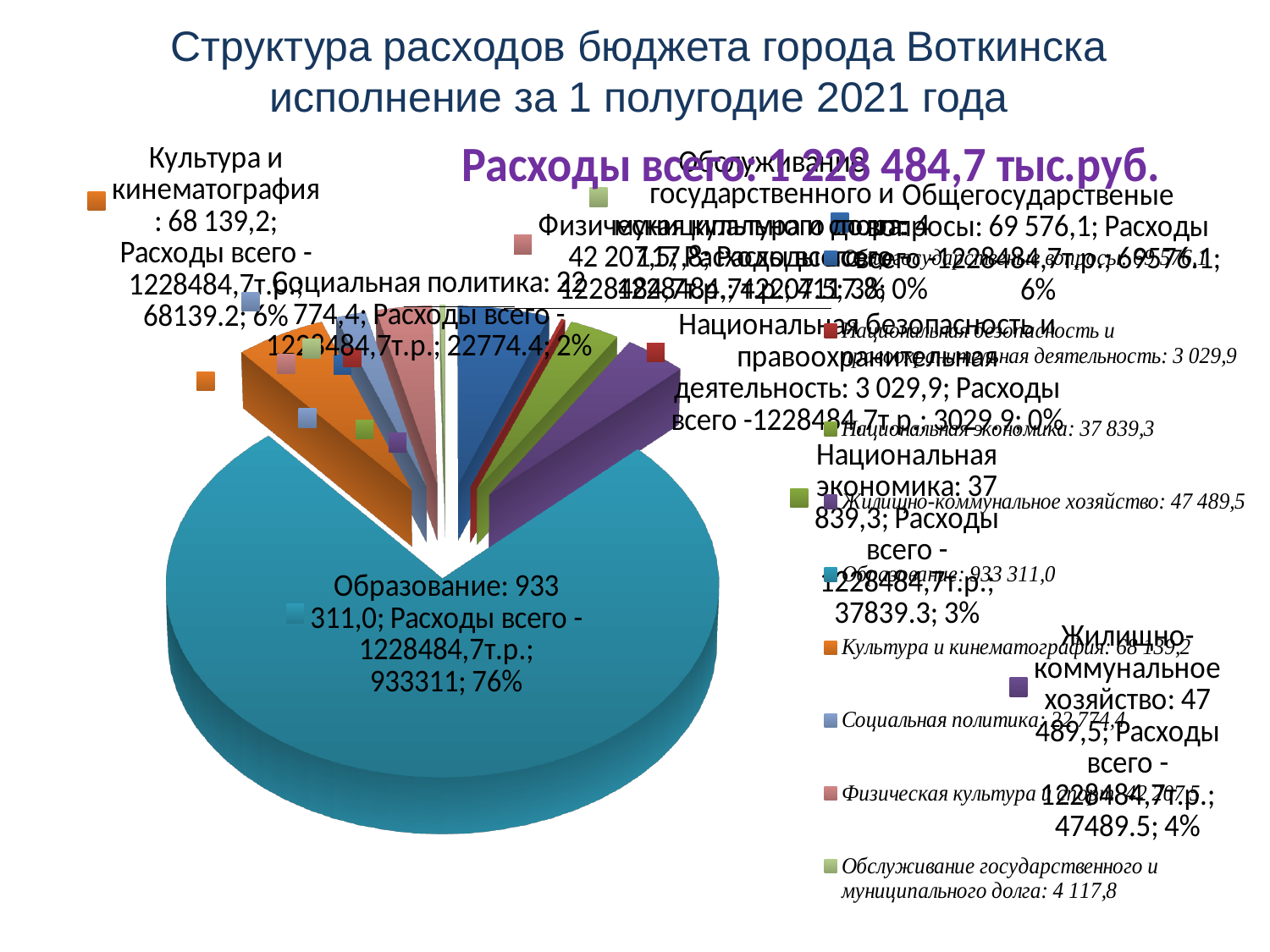
How many expenditure categories does the legend list? 9 What share of total expenditure does Образование account for? 76% What is the total expenditure shown on the slide (Расходы всего)? 1 228 484,7 тыс.руб. What is the value for Образование? 933 311,0 Which category has the largest share of expenditure? Образование Which category has the smallest value? Национальная безопасность и правоохранительная деятельность Which is larger: Общегосударственные вопросы or Культура и кинематография? Общегосударственные вопросы What is the difference between Общегосударственные вопросы (69 576,1) and Культура и кинематография (68 139,2)? 1 436,9 What kind of chart is shown on the slide? pie chart What share of total expenditure does Социальная политика account for? 2% What is the value for Национальная безопасность и правоохранительная деятельность? 3 029,9 What is the value for Жилищно-коммунальное хозяйство? 47 489,5